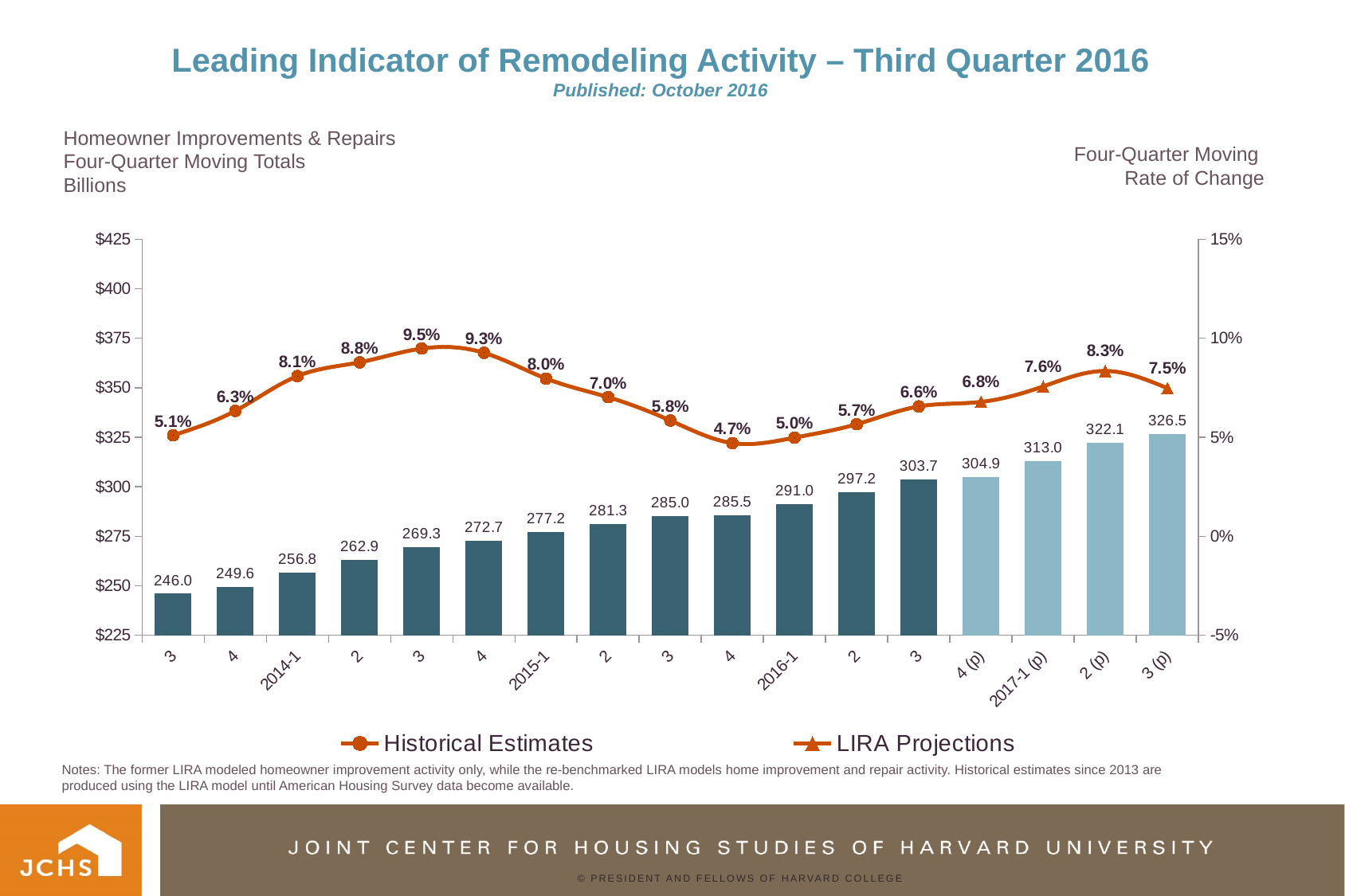
How many series does the legend list? 2 What is the difference between the four-quarter moving totals for 2017-1 (p) and 2016-1? 22.0 Which is larger, the rate of change for 2014-1 or for 2016-1? 2014-1 What is the lowest four-quarter moving rate of change shown on the line? 4.7% What is the projected four-quarter moving total for 3 (p)? 326.5 What is the projected rate of change for 2017-1 (p)? 7.6% Do the four-quarter moving totals (bars) rise or fall from left to right across the chart? rise How many bars are plotted in the chart? 17 What is the four-quarter moving rate of change for 2015-1? 8.0% What is the four-quarter moving total (in billions) for 2016-1? 291.0 Which category has the highest four-quarter moving rate of change? 3 (2014, 9.5%) Is the four-quarter moving total for 2015-1 greater or less than $300? less